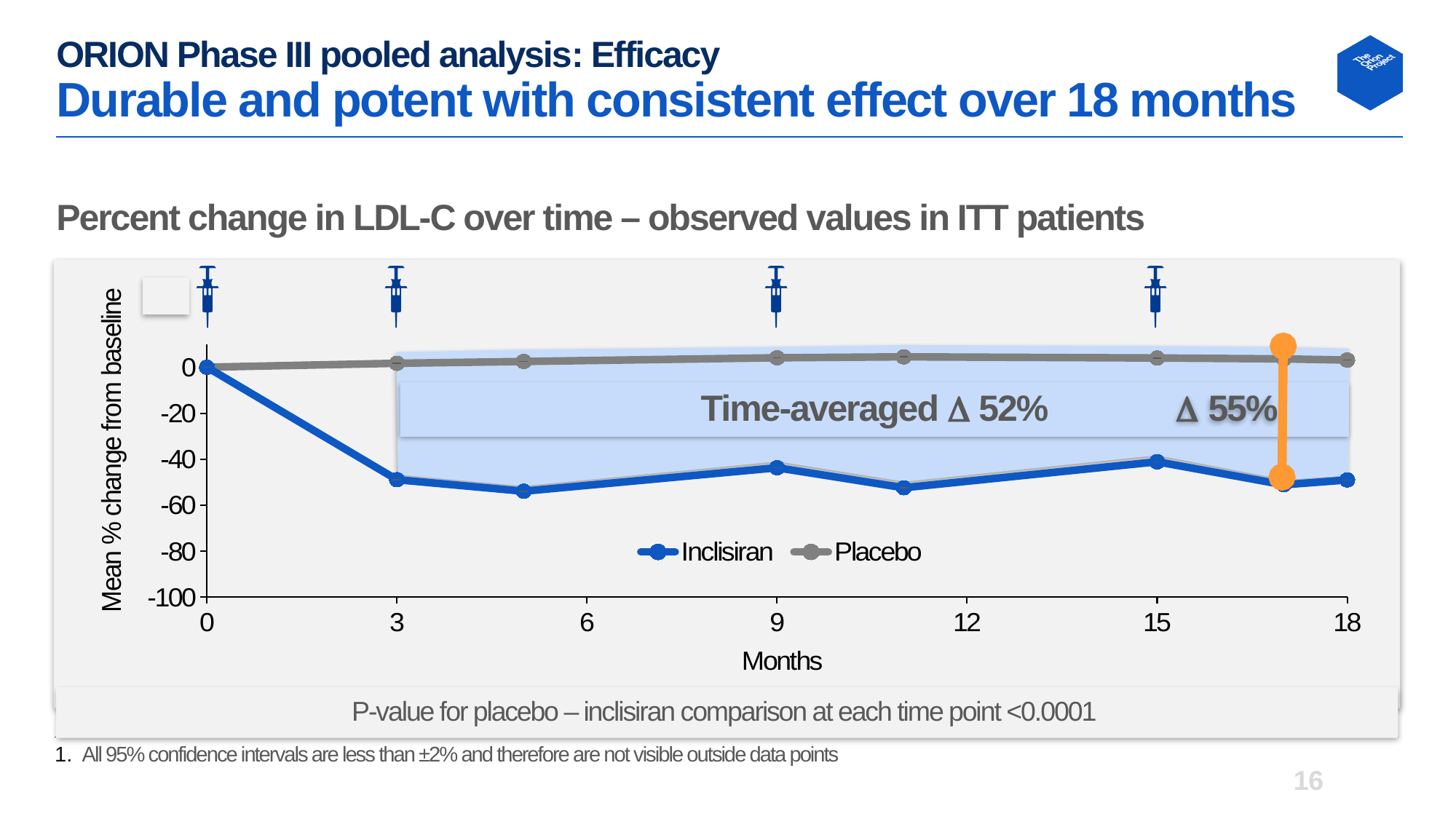
Which two series are listed in the chart legend? Inclisiran and Placebo Is the Placebo value at month 9 greater or less than -20? greater How many series does the chart legend list? 2 What is the label of the y axis? Mean % change from baseline What is the difference (Δ) between inclisiran and placebo shown near month 18 on the chart? 55% Is the Inclisiran value at month 5 greater or less than -60? greater At month 18, which series has the higher mean % change from baseline, Inclisiran or Placebo? Placebo What is the time-averaged difference (Δ) between inclisiran and placebo shown on the chart? 52% Does the Inclisiran line rise or fall between month 0 and month 3? Fall Is the Inclisiran value at month 3 greater or less than -40? less What is the label of the x axis? Months What kind of chart is shown on the slide? Line chart